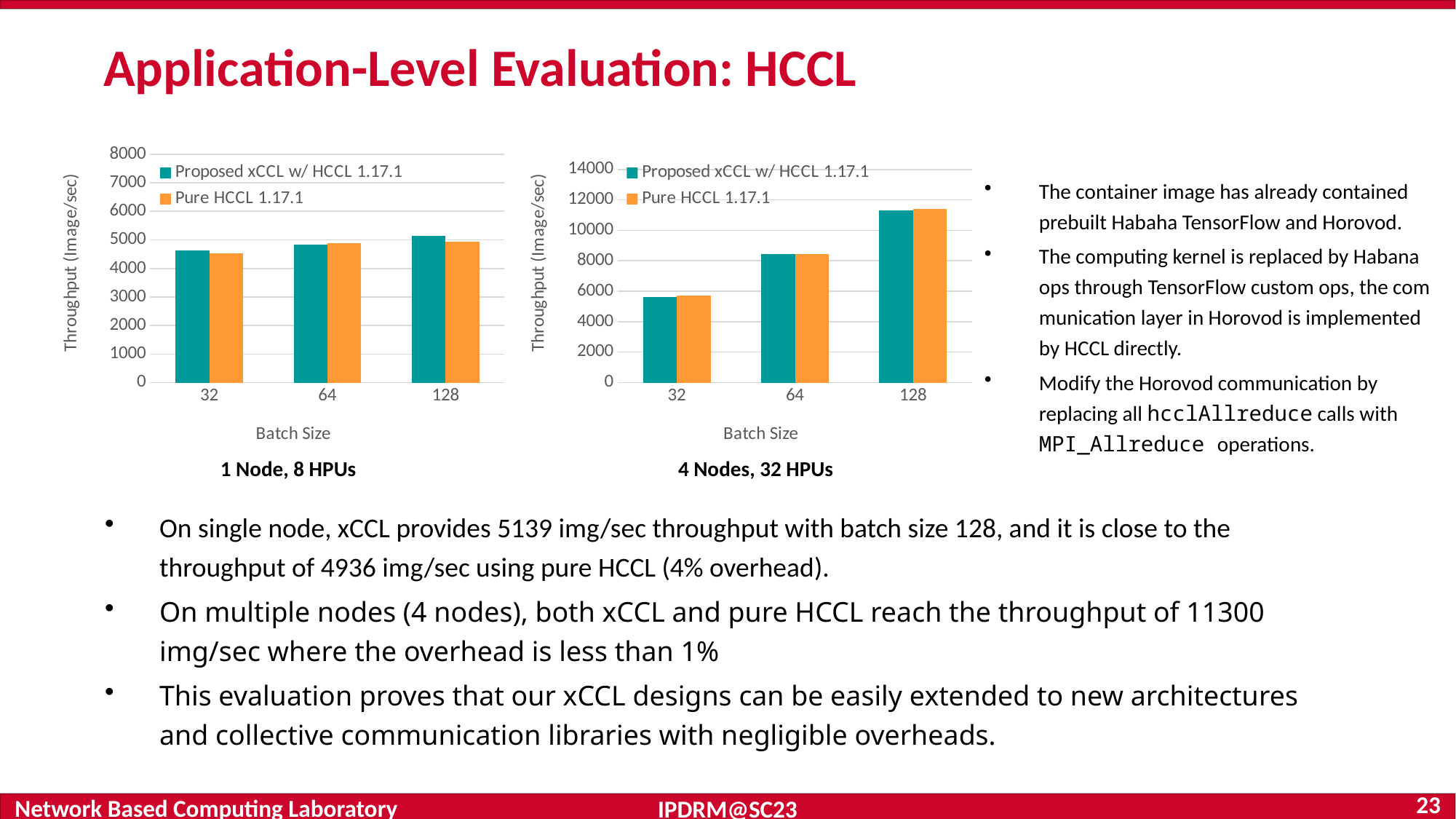
What is the y-axis label of the '1 Node, 8 HPUs' chart? Throughput (Image/sec) In the '4 Nodes, 32 HPUs' chart, at which batch size is throughput highest? 128 In the '4 Nodes, 32 HPUs' chart, is the value for Proposed xCCL w/ HCCL 1.17.1 at batch size 32 greater or less than 6000? less In the '1 Node, 8 HPUs' chart, which series has the larger value at batch size 128? Proposed xCCL w/ HCCL 1.17.1 How many series does the legend of the '4 Nodes, 32 HPUs' chart list? 2 In the '1 Node, 8 HPUs' chart, is the value for Proposed xCCL w/ HCCL 1.17.1 at batch size 128 greater or less than 5000? greater In the '4 Nodes, 32 HPUs' chart, does throughput rise or fall as batch size increases? rise What kind of chart is the '1 Node, 8 HPUs' chart? bar chart In the '4 Nodes, 32 HPUs' chart, is the value for Pure HCCL 1.17.1 at batch size 64 greater or less than 8000? greater How many batch sizes are shown on the x axis of the '1 Node, 8 HPUs' chart? 3